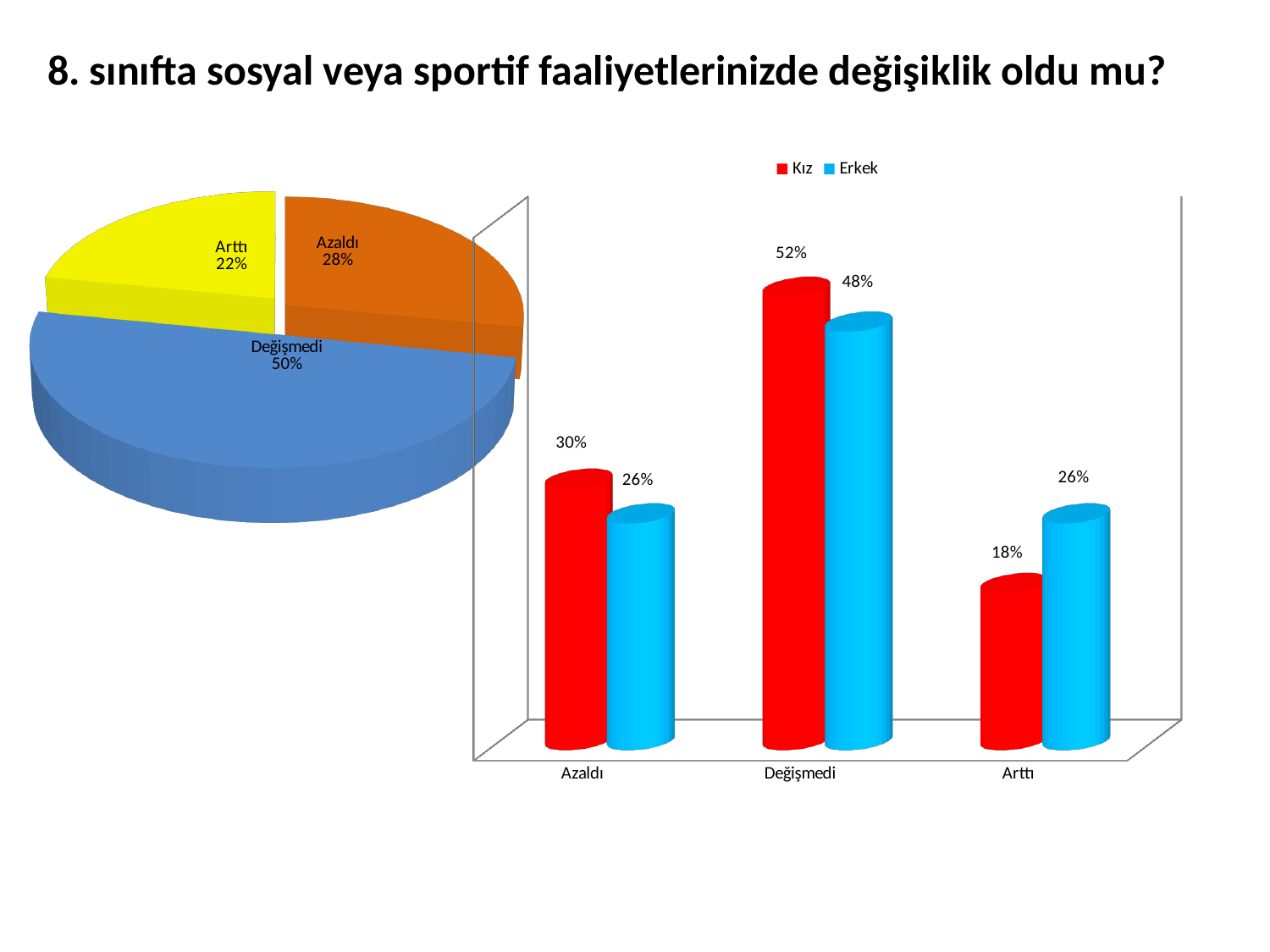
In the bar chart on the right, what is the value for Kız in the Değişmedi category? 52% What kind of chart is the chart on the right? Bar chart In the bar chart on the right, what is the value for Erkek in the Arttı category? 26% In the bar chart on the right, what is the value for Kız in the Azaldı category? 30% In the pie chart on the left, how many slices are there? 3 In the bar chart on the right, what is the difference between the Kız and Erkek values for Arttı? 8% In the bar chart on the right, which category has the lowest Kız value? Arttı In the bar chart on the right, how many series does the legend list? 2 In the bar chart on the right, which is larger for Azaldı, Kız or Erkek? Kız In the pie chart on the left, which slice is the smallest? Arttı In the pie chart on the left, what share does Değişmedi have? 50% In the pie chart on the left, what share does Azaldı have? 28%